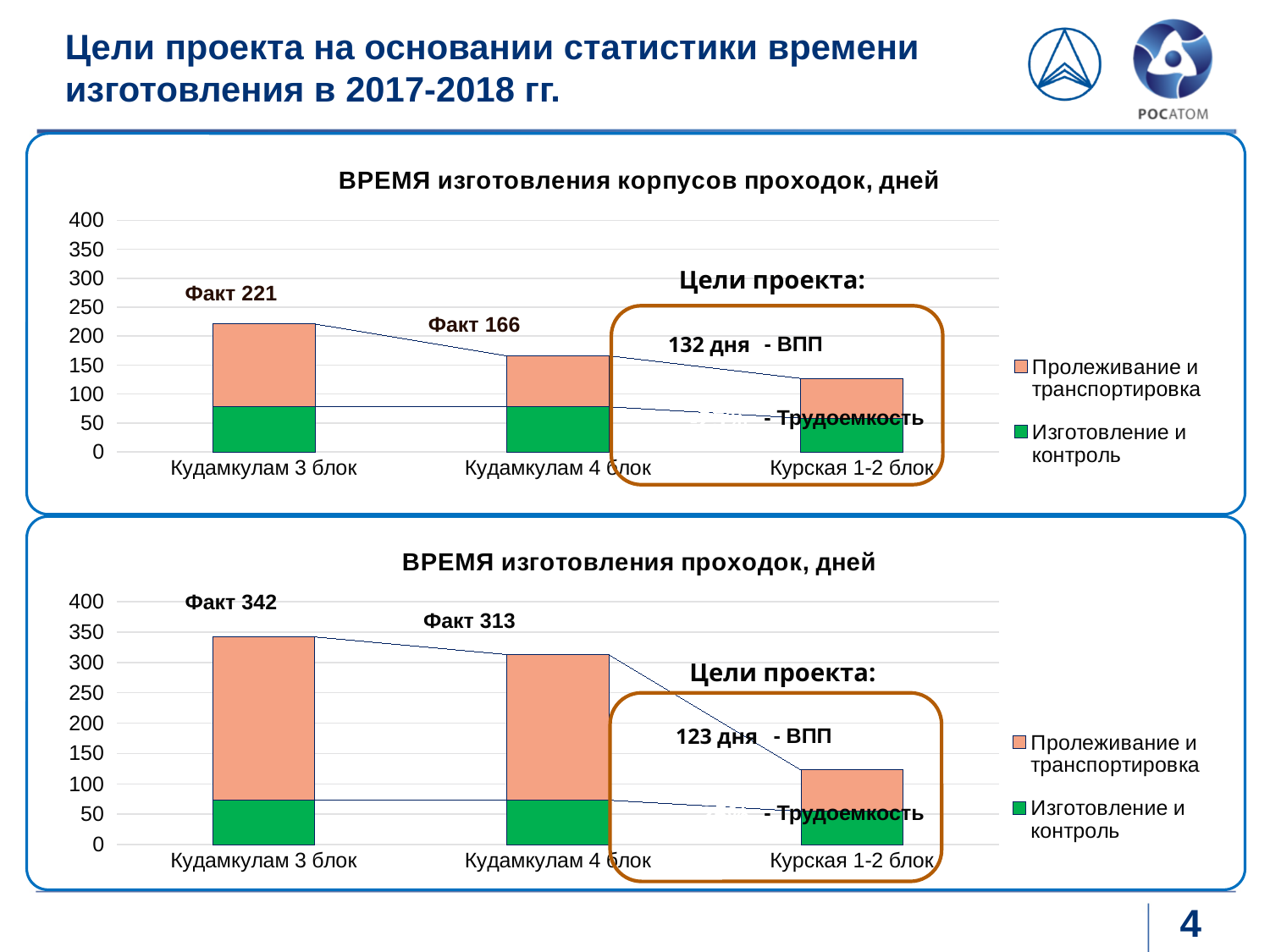
In the top chart (ВРЕМЯ изготовления корпусов проходок, дней), what target value (ВПП) is given for Курская 1-2 блок? 132 дня In the top chart (ВРЕМЯ изготовления корпусов проходок, дней), what total value is labelled for Кудамкулам 3 блок? Факт 221 In the top chart (ВРЕМЯ изготовления корпусов проходок, дней), which category has the lowest total? Курская 1-2 блок In the bottom chart (ВРЕМЯ изготовления проходок, дней), which category has the highest total? Кудамкулам 3 блок In the bottom chart (ВРЕМЯ изготовления проходок, дней), do the totals rise or fall from left to right across the categories? fall In the top chart (ВРЕМЯ изготовления корпусов проходок, дней), what is the difference between the totals for Кудамкулам 3 блок and Кудамкулам 4 блок? 55 In the bottom chart (ВРЕМЯ изготовления проходок, дней), what is the difference between the totals for Кудамкулам 3 блок and Кудамкулам 4 блок? 29 In the top chart (ВРЕМЯ изготовления корпусов проходок, дней), what total value is labelled for Кудамкулам 4 блок? Факт 166 What kind of chart is the bottom chart (ВРЕМЯ изготовления проходок, дней)? stacked bar chart In the bottom chart (ВРЕМЯ изготовления проходок, дней), what total value is labelled for Кудамкулам 3 блок? Факт 342 In the bottom chart (ВРЕМЯ изготовления проходок, дней), what target value (ВПП) is given for Курская 1-2 блок? 123 дня How many series does the legend of the top chart (ВРЕМЯ изготовления корпусов проходок, дней) list? 2